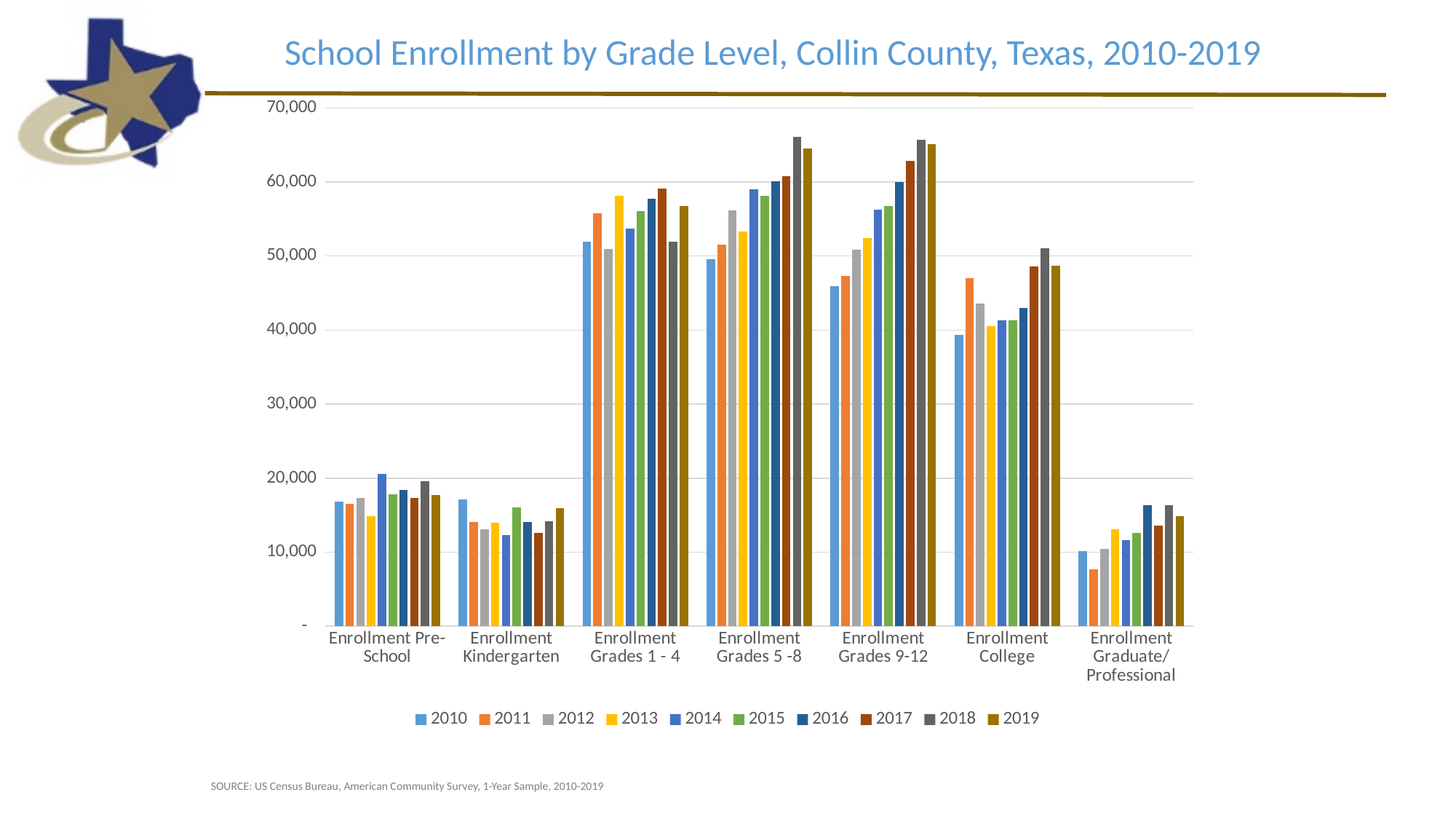
Is the 2013 value for Enrollment Grades 1 - 4 greater or less than 50,000? greater How many series (years) does the legend list? 10 Is the 2018 value for Enrollment Grades 9-12 greater or less than 60,000? greater Is the 2011 value for Enrollment Graduate/Professional greater or less than 10,000? less Do the Enrollment Grades 9-12 values rise or fall from 2010 to 2018? rise How many grade-level categories are shown along the x axis? 7 What kind of chart is shown on the slide? bar chart Within Enrollment Graduate/Professional, which year has the lowest enrollment? 2011 Within Enrollment College, which year has the highest enrollment? 2018 Within Enrollment Pre-School, which year has the highest enrollment? 2014 Which grade-level category has the lowest enrollment values overall? Enrollment Graduate/Professional Which is larger in 2010: Enrollment Grades 1 - 4 or Enrollment Grades 9-12? Enrollment Grades 1 - 4